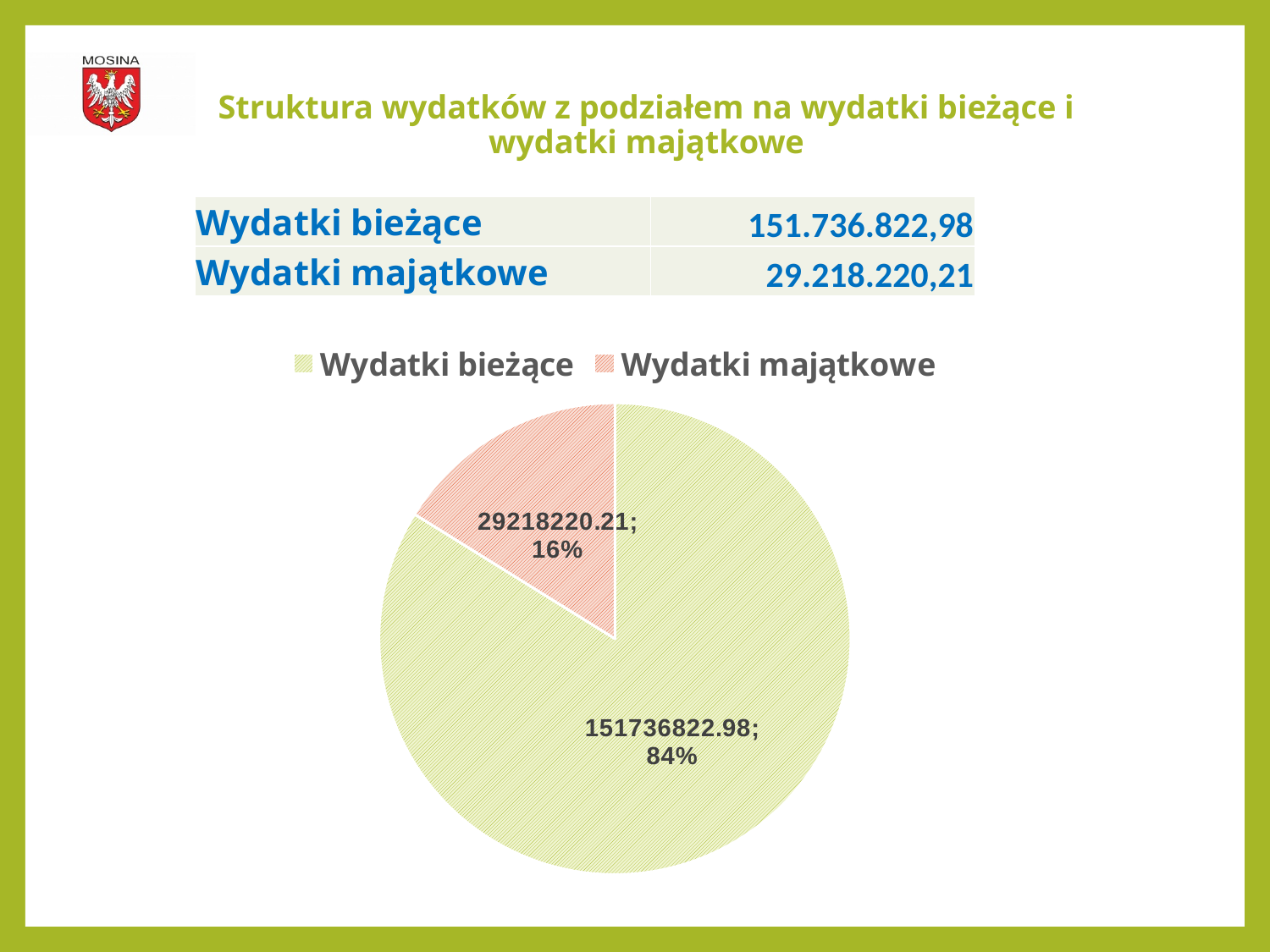
Which is larger, Wydatki bieżące or Wydatki majątkowe? Wydatki bieżące What is the difference in percentage points between the Wydatki bieżące share and the Wydatki majątkowe share? 68 percentage points Which slice of the pie chart is the smallest? Wydatki majątkowe What share of the pie does Wydatki majątkowe represent? 16% What value is labelled on the Wydatki bieżące slice of the pie chart? 151736822.98 What kind of chart is shown on the slide? pie chart How many entries does the legend of the pie chart list? 2 What share of the pie does Wydatki bieżące represent? 84% How many slices does the pie chart have? 2 Which legend entry is shown with a red/pink pattern in the pie chart? Wydatki majątkowe Which slice of the pie chart is the largest? Wydatki bieżące What value is labelled on the Wydatki majątkowe slice of the pie chart? 29218220.21